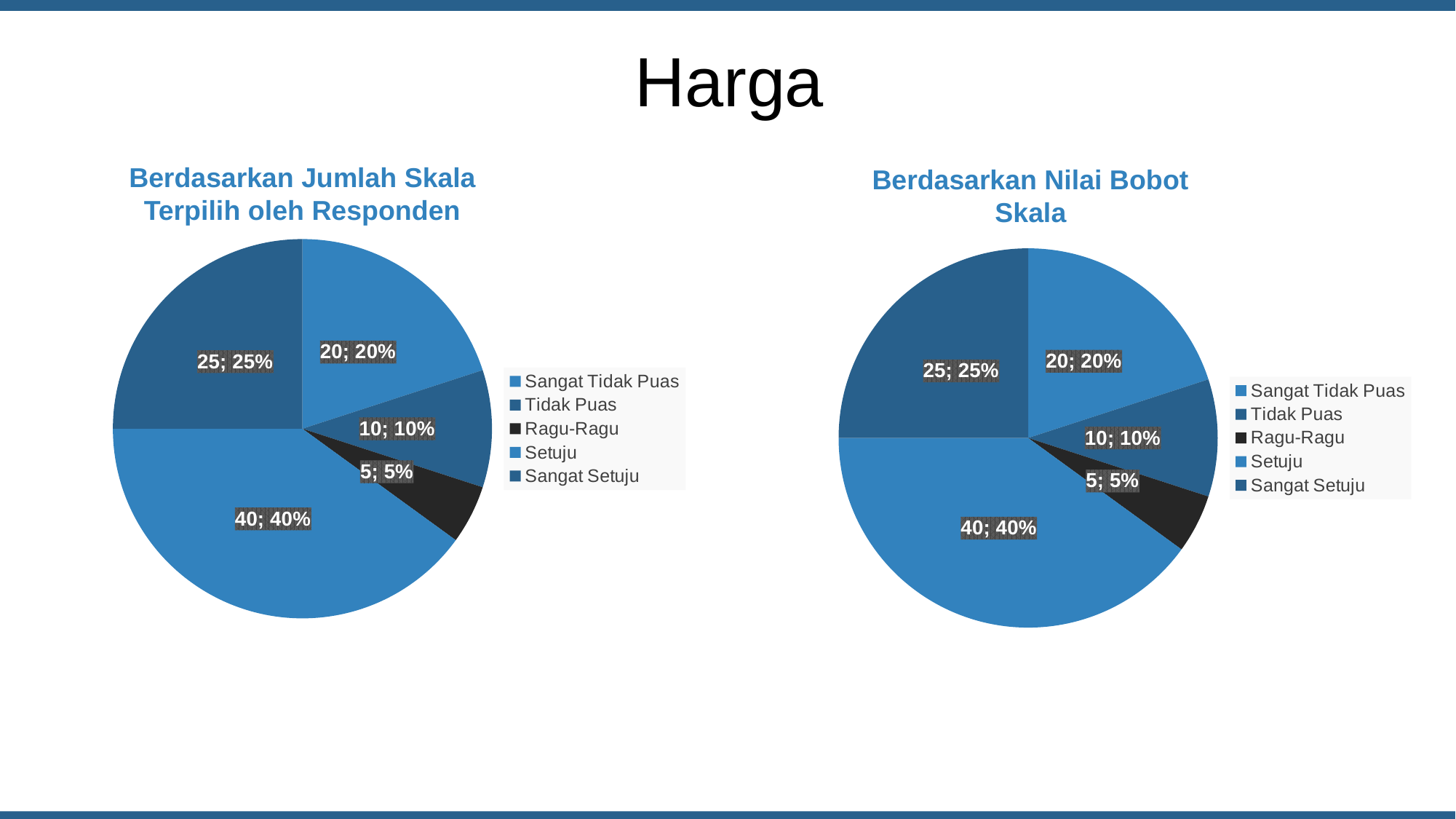
How many categories does the legend of the left chart, 'Berdasarkan Jumlah Skala Terpilih oleh Responden', list? 5 In the right chart, 'Berdasarkan Nilai Bobot Skala', what is the value for Sangat Setuju? 25; 25% In the right chart, 'Berdasarkan Nilai Bobot Skala', which category is shown in black? Ragu-Ragu In the right chart, 'Berdasarkan Nilai Bobot Skala', which is larger, Sangat Setuju or Sangat Tidak Puas? Sangat Setuju In the left chart, 'Berdasarkan Jumlah Skala Terpilih oleh Responden', what is the value for Ragu-Ragu? 5; 5% What kind of chart is the left chart, 'Berdasarkan Jumlah Skala Terpilih oleh Responden'? Pie chart In the right chart, 'Berdasarkan Nilai Bobot Skala', what share of the pie does Sangat Tidak Puas take? 20% In the left chart, 'Berdasarkan Jumlah Skala Terpilih oleh Responden', what is the difference between the values for Setuju and Sangat Tidak Puas? 20 In the left chart, 'Berdasarkan Jumlah Skala Terpilih oleh Responden', what is the value for Setuju? 40; 40% In the left chart, 'Berdasarkan Jumlah Skala Terpilih oleh Responden', which category has the largest slice? Setuju In the right chart, 'Berdasarkan Nilai Bobot Skala', what is the value for Tidak Puas? 10; 10% In the right chart, 'Berdasarkan Nilai Bobot Skala', which category has the smallest slice? Ragu-Ragu